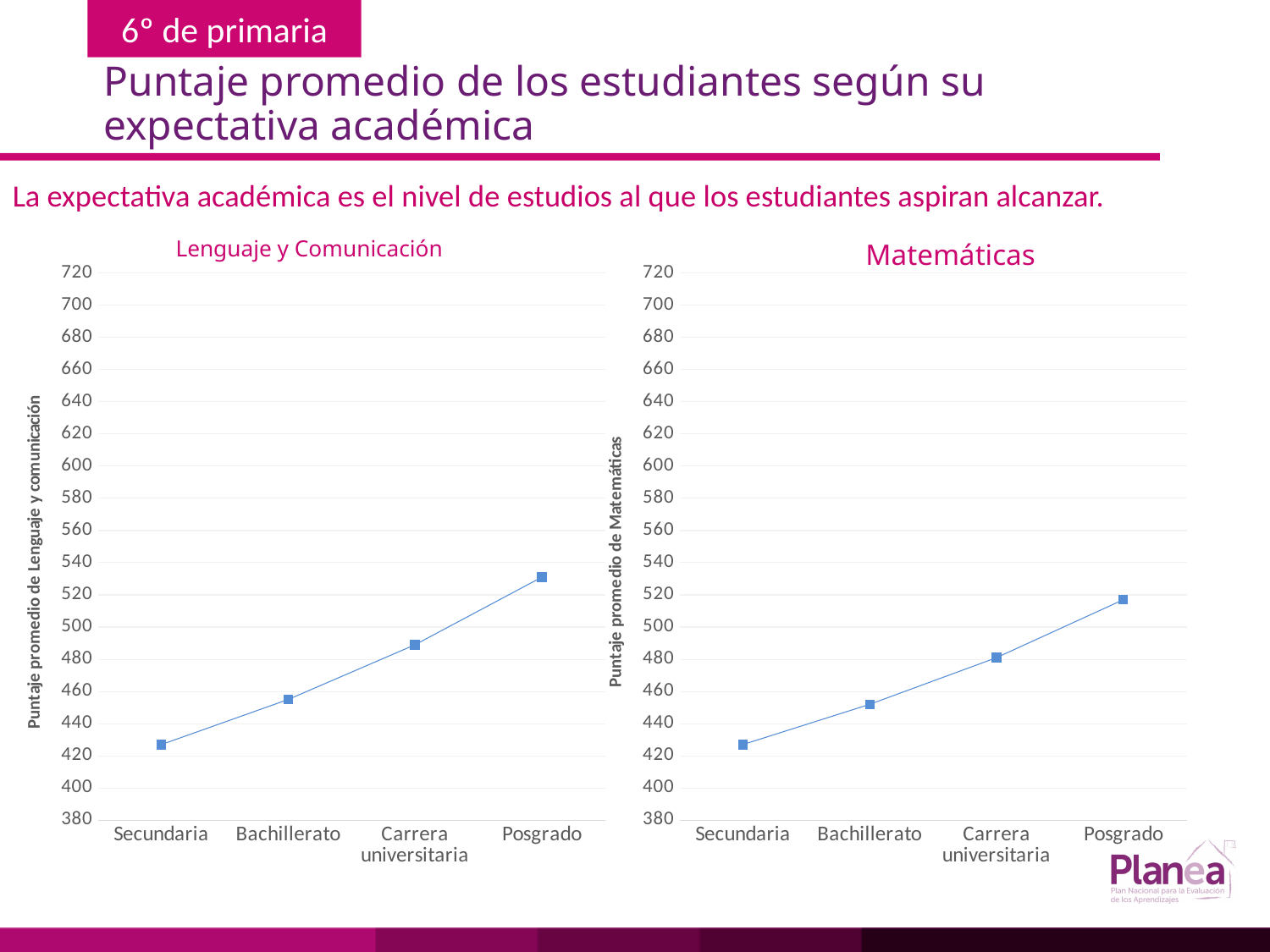
In the Lenguaje y Comunicación chart, which category has the lowest average score? Secundaria In the Lenguaje y Comunicación chart, is the value for Secundaria greater or less than 440? less How many categories are shown on the x axis of the Lenguaje y Comunicación chart? 4 In the Matemáticas chart, which category has the lowest average score? Secundaria In the Matemáticas chart, is the value for Bachillerato greater or less than 460? less In the Lenguaje y Comunicación chart, which category has the highest average score? Posgrado In the Matemáticas chart, is the value for Carrera universitaria greater or less than 460? greater In the Matemáticas chart, which is larger, the value for Bachillerato or the value for Carrera universitaria? Carrera universitaria In the Lenguaje y Comunicación chart, do the values rise or fall from Secundaria to Posgrado? Rise In the Matemáticas chart, which category has the highest average score? Posgrado What kind of chart is the Matemáticas chart? Line chart